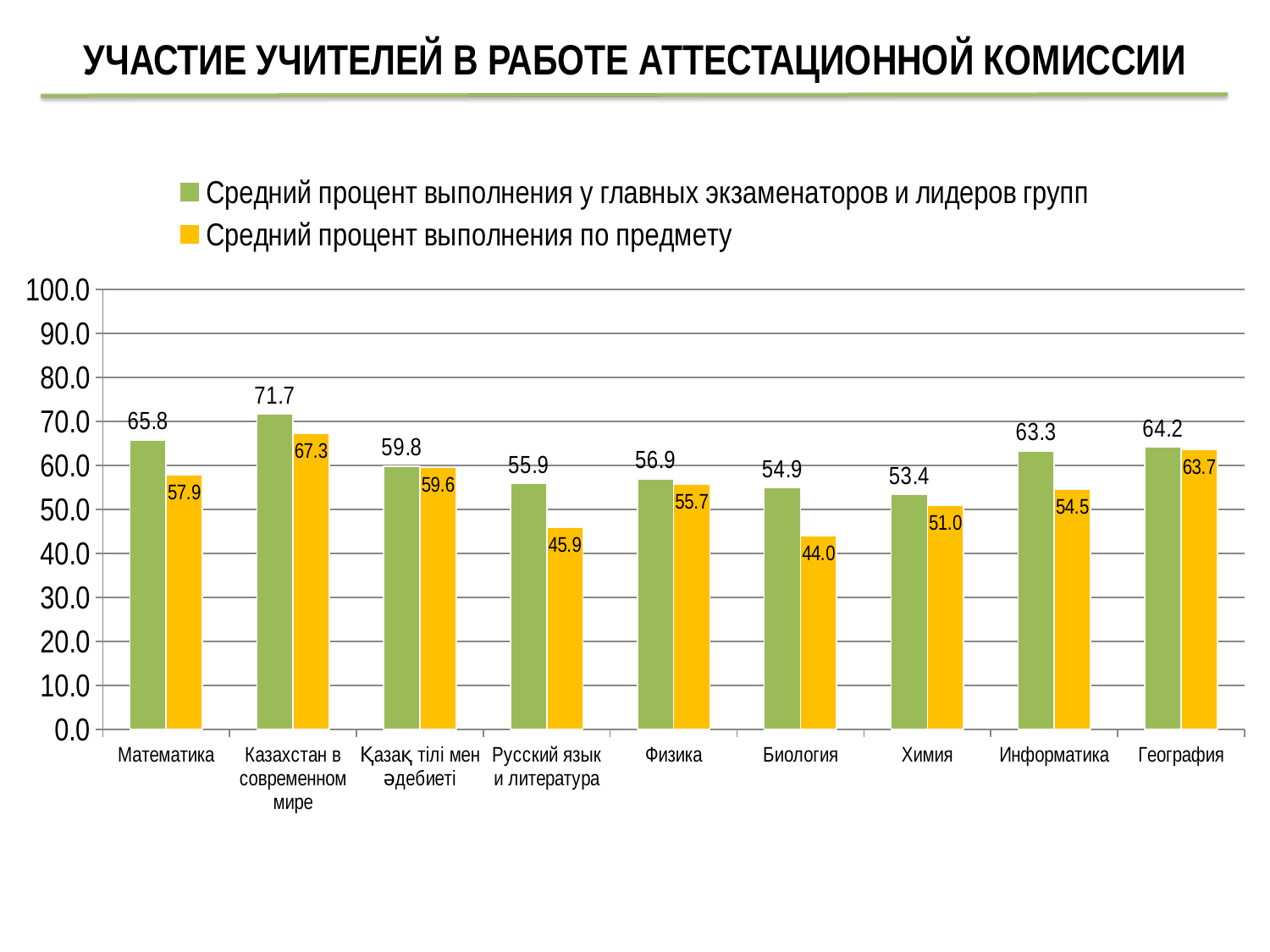
What is the title of the slide? УЧАСТИЕ УЧИТЕЛЕЙ В РАБОТЕ АТТЕСТАЦИОННОЙ КОМИССИИ Which category has the lowest value for 'Средний процент выполнения по предмету'? Биология Which category has the highest value for 'Средний процент выполнения у главных экзаменаторов и лидеров групп'? Казахстан в современном мире What is the value of 'Средний процент выполнения по предмету' for Биология? 44.0 Which is larger for Қазақ тілі мен әдебиеті: 'Средний процент выполнения у главных экзаменаторов и лидеров групп' or 'Средний процент выполнения по предмету'? Средний процент выполнения у главных экзаменаторов и лидеров групп What kind of chart is shown on the slide? bar chart What is the difference between the two series for Русский язык и литература? 10.0 What is the value of 'Средний процент выполнения по предмету' for Информатика? 54.5 Is the value of 'Средний процент выполнения по предмету' for Химия greater or less than 60.0? less What is the value of 'Средний процент выполнения у главных экзаменаторов и лидеров групп' for Математика? 65.8 How many series does the legend list? 2 How many categories are shown on the x axis? 9